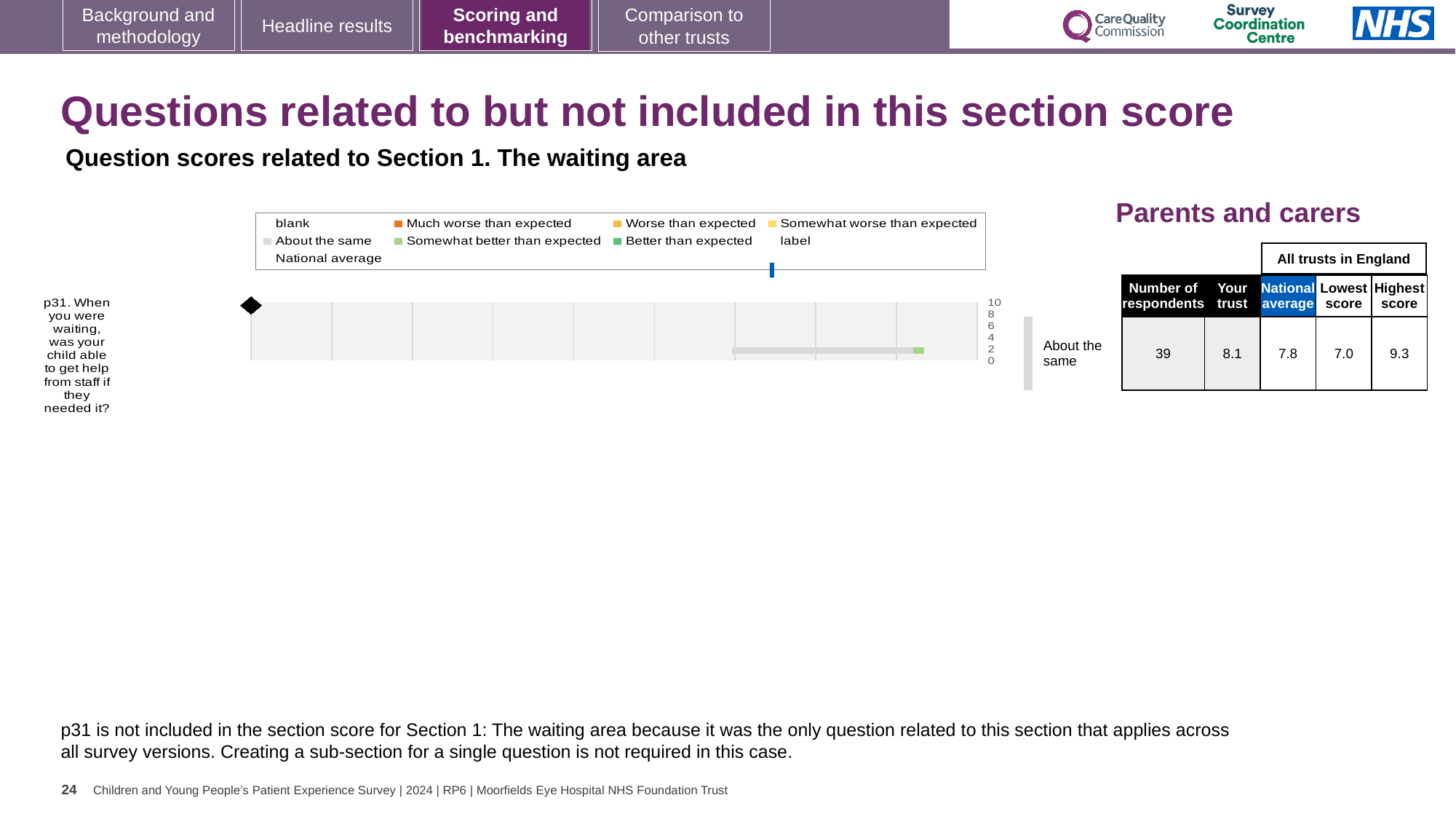
What is the highest score among all trusts in England for p31? 9.3 What kind of chart is shown for question p31? bar chart How many survey questions are plotted in the chart? 1 Which is larger for p31, the 'Your trust' score or the national average? Your trust What is the 'Your trust' score for p31 in the Parents and carers table? 8.1 What is the national average score for p31? 7.8 What benchmark category label is shown to the right of the bar for p31? About the same What is the lowest score among all trusts in England for p31? 7.0 Which question number is plotted in the chart? p31 What is the difference between the highest score and the lowest score for p31? 2.3 By how much does the 'Your trust' score for p31 exceed the national average? 0.3 How many respondents answered p31? 39